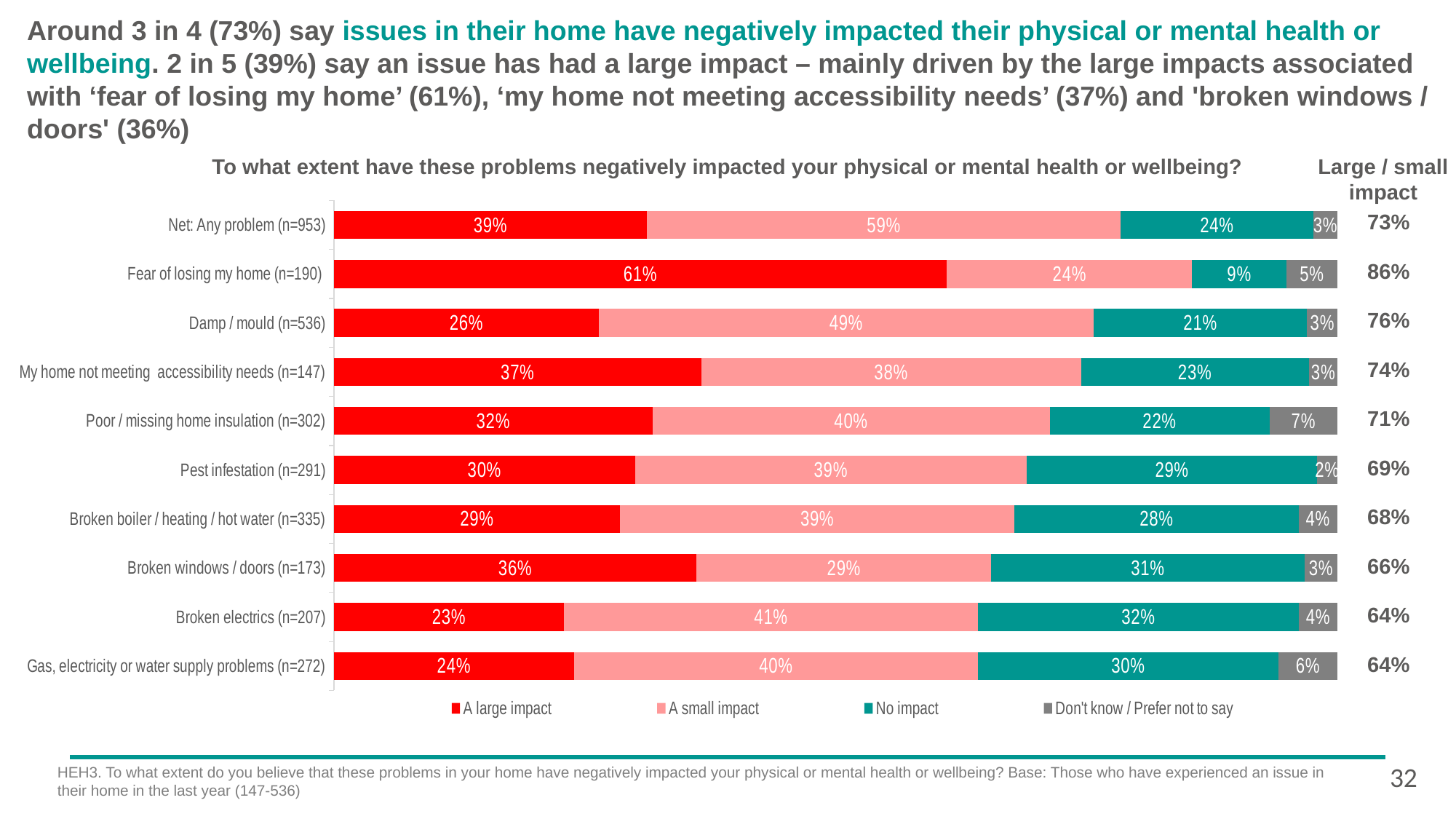
What is the combined 'Large / small impact' figure shown for Gas, electricity or water supply problems (n=272)? 64% What is the difference between the 'A large impact' values for Fear of losing my home (n=190) and Damp / mould (n=536)? 35% Which category has the lowest 'A large impact' value? Broken electrics (n=207) How many series does the legend list? 4 What kind of chart is shown on the slide? Stacked bar chart What is the 'Don't know / Prefer not to say' value for Poor / missing home insulation (n=302)? 7% What is the 'No impact' value for Broken electrics (n=207)? 32% What is the 'A small impact' value for Damp / mould (n=536)? 49% Which category has the highest 'A large impact' value? Fear of losing my home (n=190) How many categories are plotted on the chart? 10 What is the 'A large impact' value for Fear of losing my home (n=190)? 61% Which is larger: the 'No impact' value for Broken windows / doors (n=173) or for Pest infestation (n=291)? Broken windows / doors (n=173)